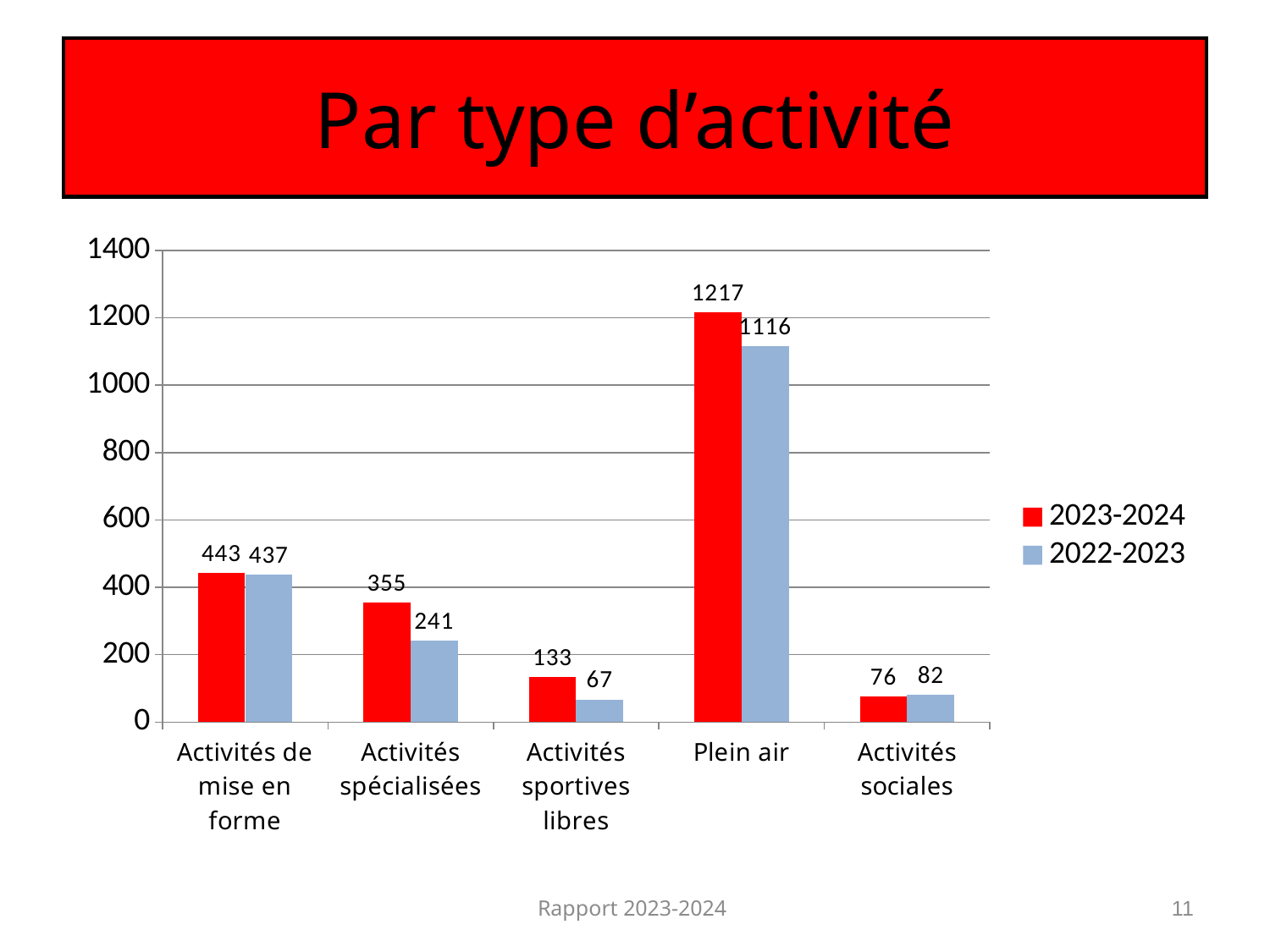
What is the title of the slide? Par type d’activité How many series does the legend list? 2 What kind of chart is shown on the slide? Bar chart What is the value for Activités spécialisées in the 2022-2023 series? 241 For Activités sociales, which series has the larger value, 2023-2024 or 2022-2023? 2022-2023 Which category has the lowest value in the 2022-2023 series? Activités sportives libres How many categories are shown on the x axis? 5 What is the value for Activités sociales in the 2023-2024 series? 76 Which category has the highest value in the 2023-2024 series? Plein air What is the difference between the 2023-2024 and 2022-2023 values for Activités sportives libres? 66 What is the value for Plein air in the 2023-2024 series? 1217 What is the difference between the 2023-2024 and 2022-2023 values for Plein air? 101